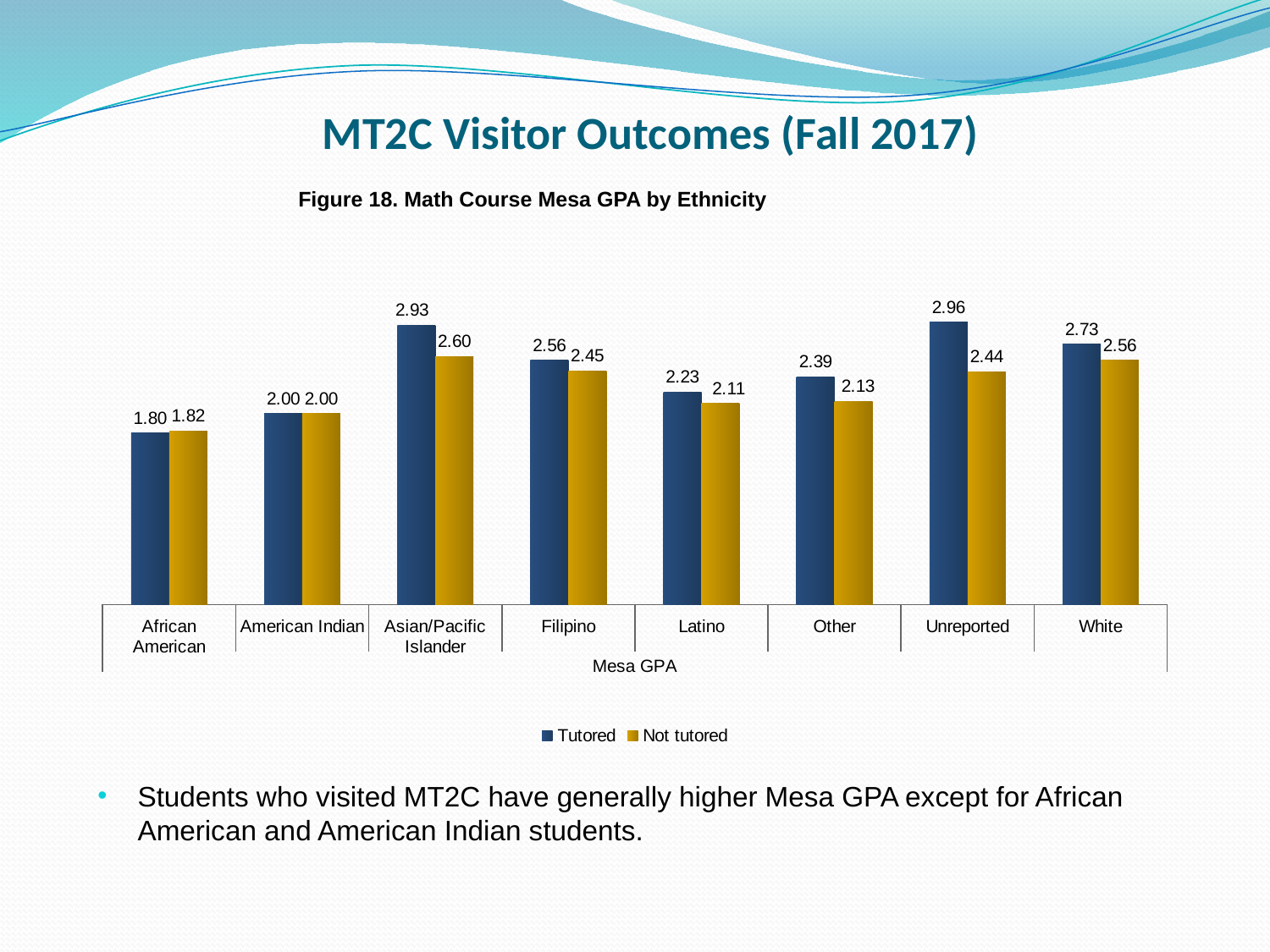
How many series does the legend list? 2 What is the Tutored Mesa GPA for Asian/Pacific Islander students? 2.93 How many ethnicity categories are shown on the x axis? 8 Which ethnicity category has the highest Tutored Mesa GPA? Unreported Which ethnicity category has the lowest Not tutored Mesa GPA? African American What is the Not tutored Mesa GPA for Latino students? 2.11 What is the difference between the Tutored and Not tutored Mesa GPA for Other students? 0.26 Which is larger for African American students, the Tutored or the Not tutored Mesa GPA? Not tutored Which is larger for Filipino students, the Tutored or the Not tutored Mesa GPA? Tutored What is the difference between the Tutored and Not tutored Mesa GPA for Unreported students? 0.52 What is the Tutored Mesa GPA for White students? 2.73 What kind of chart is shown in Figure 18? Bar chart